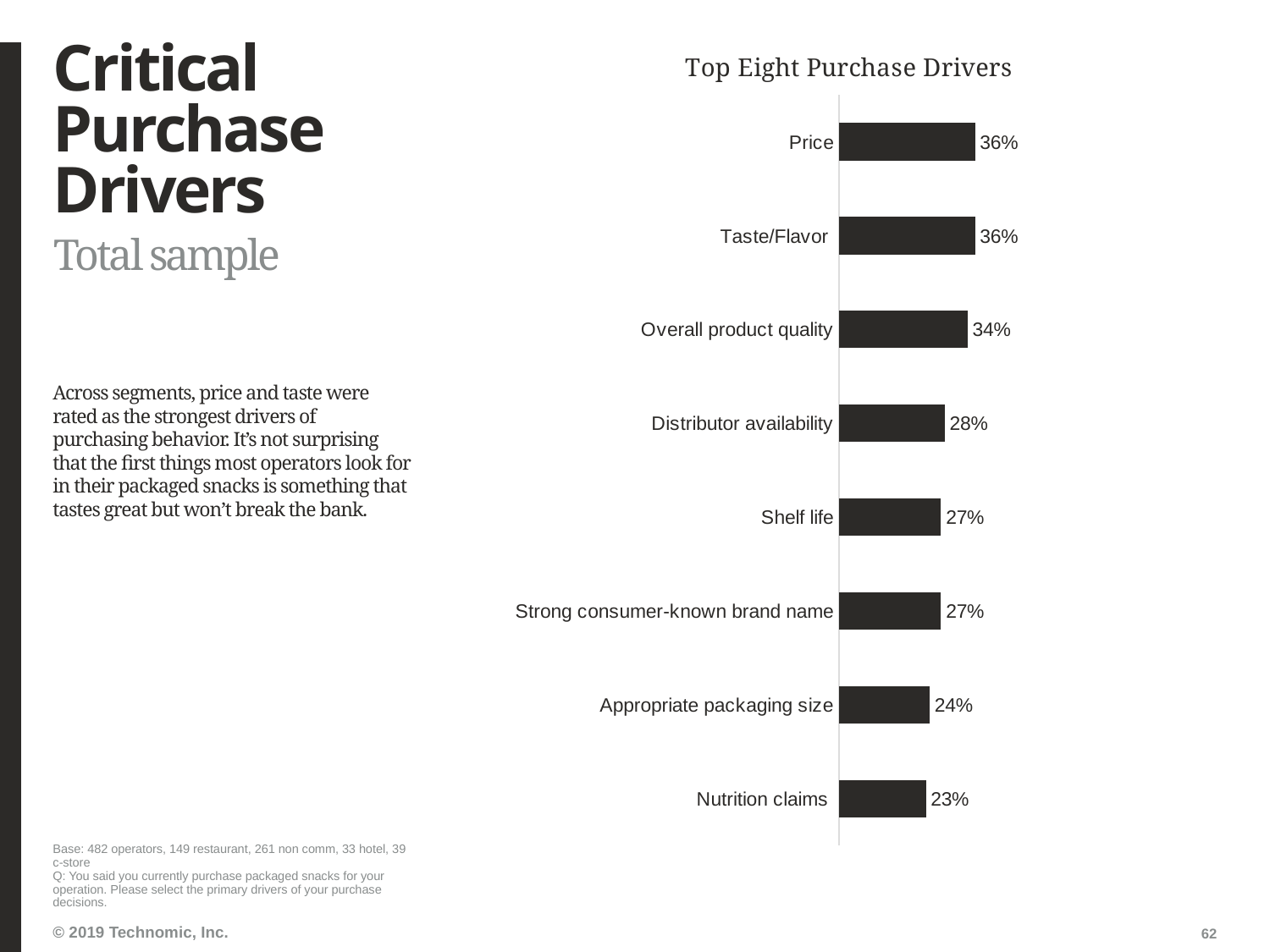
What kind of chart is shown on the slide? Bar chart What is the difference between the values for Overall product quality and Distributor availability? 6% What is the difference between the values for Price and Nutrition claims? 13% Which is larger, the value for Appropriate packaging size or the value for Nutrition claims? Appropriate packaging size What is the value for Shelf life? 27% What is the value for Appropriate packaging size? 24% Which purchase driver has the lowest value? Nutrition claims Which is larger, the value for Taste/Flavor or the value for Shelf life? Taste/Flavor What is the value for Distributor availability? 28% What is the value for Overall product quality? 34% What is the title of the chart? Top Eight Purchase Drivers How many purchase drivers are shown in the chart? 8